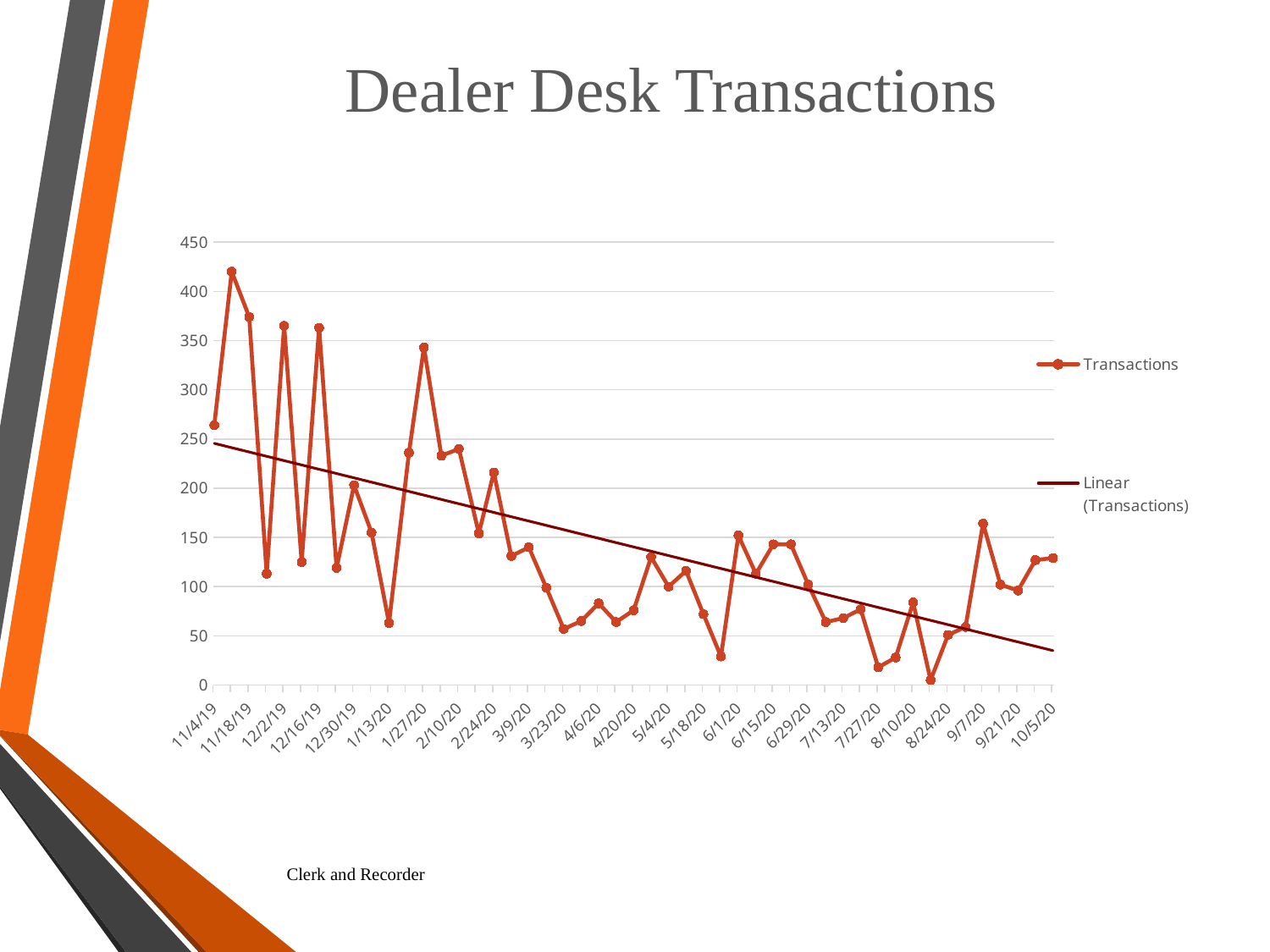
Which date has the higher Transactions value, 1/27/20 or 10/5/20? 1/27/20 What is the title of the chart? Dealer Desk Transactions Which date has the higher Transactions value, 11/18/19 or 1/13/20? 11/18/19 Is the Transactions value for 1/27/20 greater or less than 300? greater What type of chart is shown on the slide? Line chart Is the Transactions value for 7/27/20 greater or less than 50? less How many series does the legend list? 2 Is the Transactions value for 10/5/20 greater or less than 100? greater What are the two entries in the chart legend? Transactions and Linear (Transactions) Does the Transactions line generally rise or fall from 11/4/19 to 10/5/20? Fall